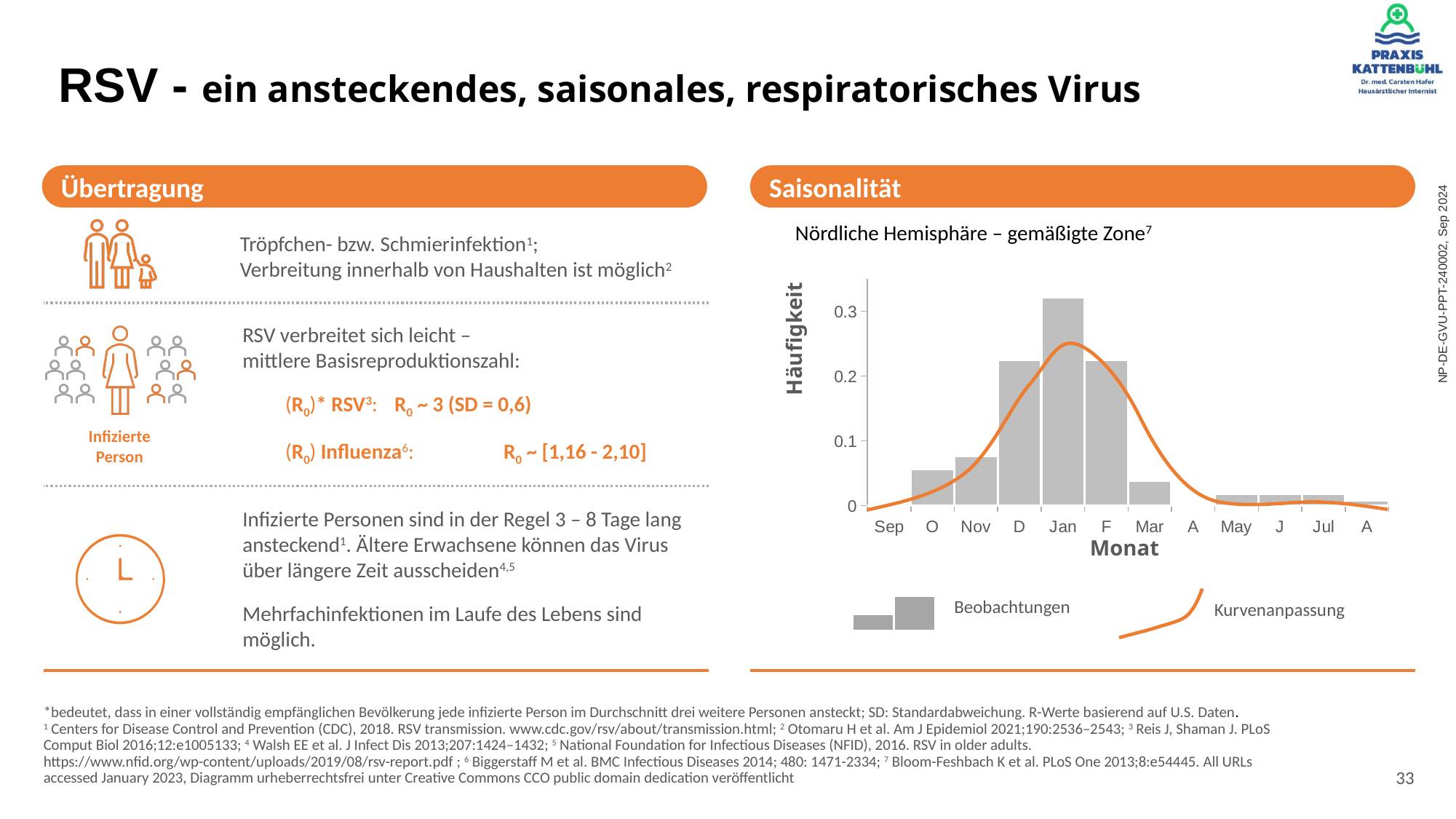
Which is larger, the value for Jan or the value for Mar? Jan How many entries does the legend of the seasonality chart list? 2 Do the bar values rise or fall from Sep to Jan? rise Is the value for F (February) greater or less than 0.2? greater What is the title of the seasonality chart? Nördliche Hemisphäre – gemäßigte Zone How many month labels are shown on the x axis of the seasonality chart? 12 Is the value for Jan greater or less than 0.3? greater Is the value for Nov greater or less than 0.1? less Which month has the highest bar in the seasonality chart? Jan What kind of chart is shown under 'Saisonalität'? Bar chart (with a fitted curve)